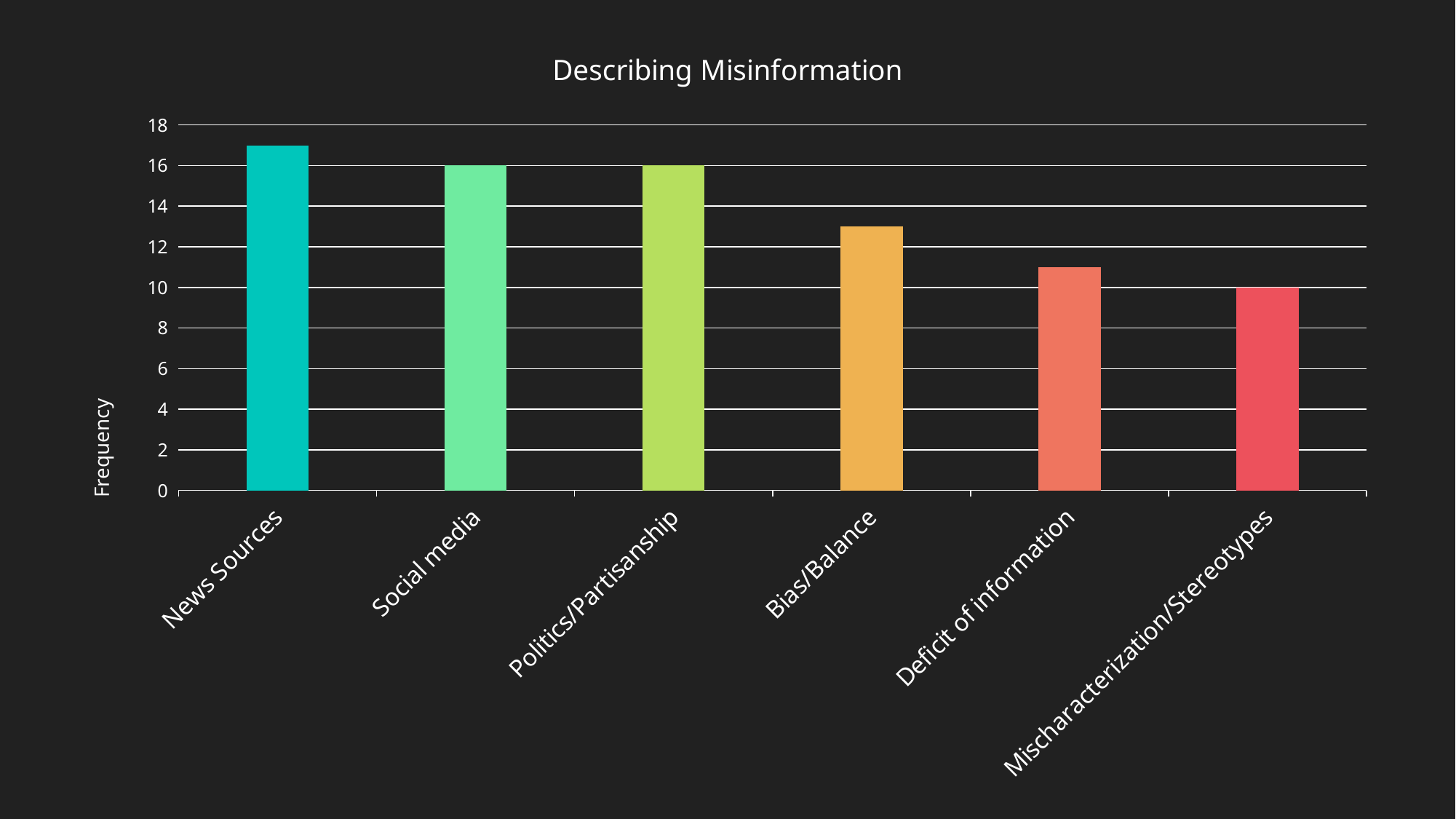
What is the title of the chart? Describing Misinformation Which category has the highest frequency? News Sources What type of chart is shown on the slide? Bar chart Is the value for Deficit of information greater or less than 12? less What is the frequency for Politics/Partisanship? 16 What is the label on the vertical axis? Frequency What is the frequency for Mischaracterization/Stereotypes? 10 What is the frequency for Social media? 16 Which category has the lowest frequency? Mischaracterization/Stereotypes Is the value for Bias/Balance greater or less than 12? greater Is the value for News Sources greater or less than 16? greater How many categories are plotted on the chart? 6